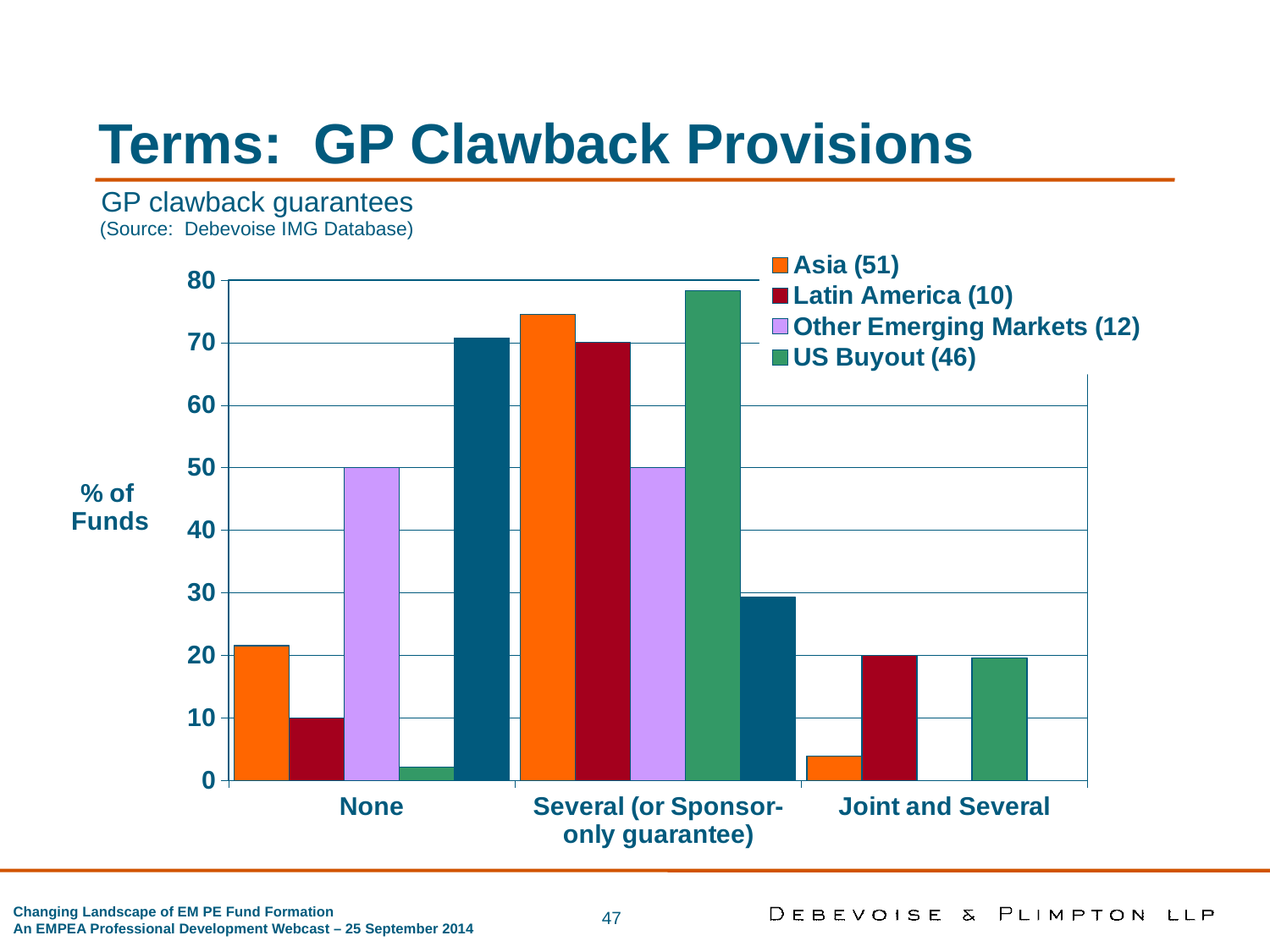
Which legend series has the lowest value in the None category? US Buyout (46) What is the value for Latin America (10) in the Several (or Sponsor-only guarantee) category? 70 Which legend series has the highest value in the Several (or Sponsor-only guarantee) category? US Buyout (46) What is the difference between the Latin America (10) values for Several (or Sponsor-only guarantee) and None? 60 How many categories are shown on the x axis? 3 Is the value for Asia (51) in the None category greater or less than 30? less What is the value for Latin America (10) in the Joint and Several category? 20 Is the value for US Buyout (46) in the Several (or Sponsor-only guarantee) category greater or less than 70? greater What kind of chart is shown on the slide? Bar chart What is the value for Other Emerging Markets (12) in the None category? 50 What is the value for Latin America (10) in the None category? 10 How many series does the legend list? 4